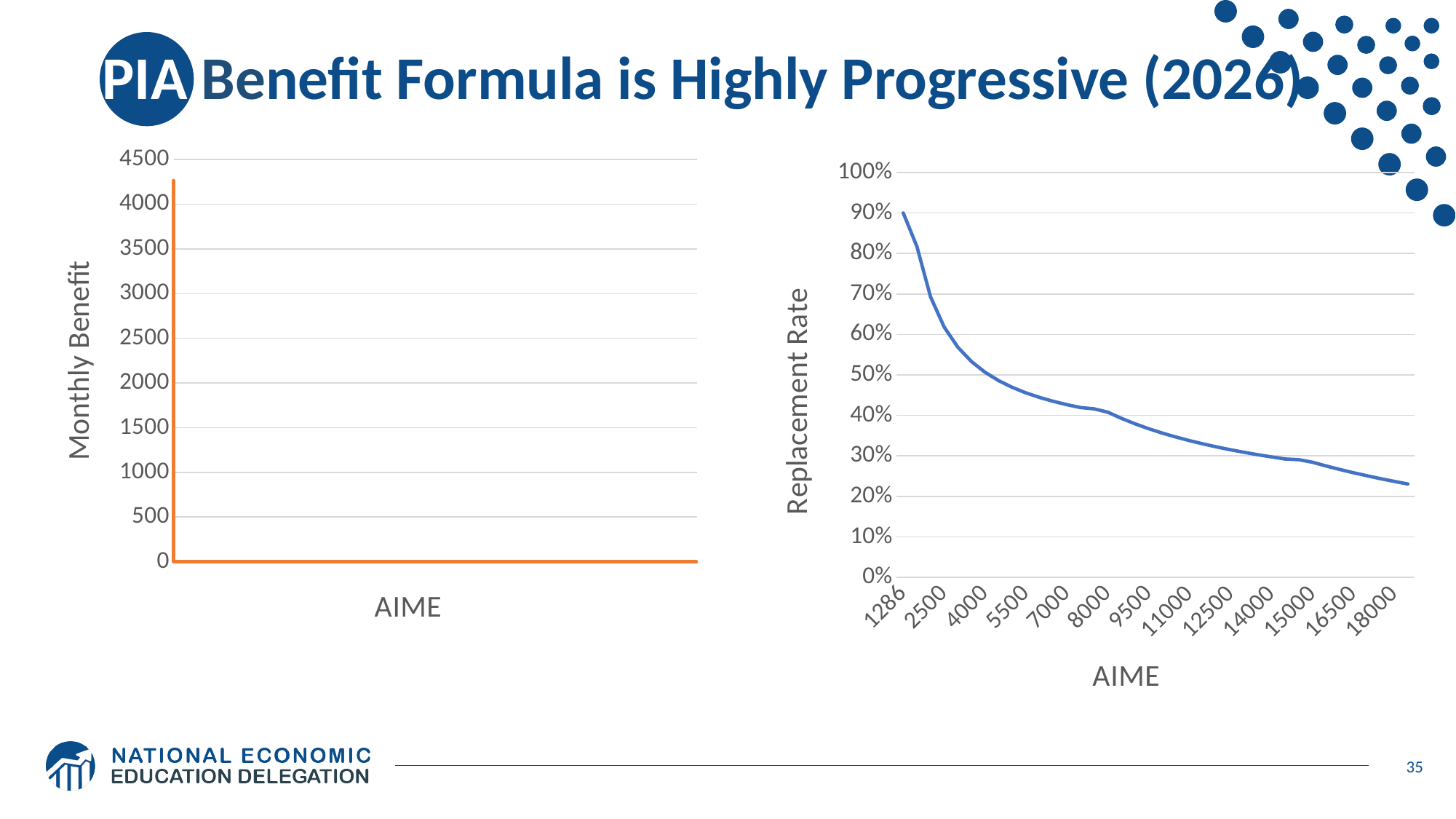
What is the y-axis title of the left-hand chart? Monthly Benefit What is the y-axis title of the right-hand chart? Replacement Rate In the right-hand chart, at which AIME value is the replacement rate highest? 1286 In the right-hand chart, does the replacement rate rise or fall as AIME increases? fall In the right-hand chart, is the replacement rate at AIME 2500 greater or less than 70%? less In the right-hand chart, is the replacement rate at AIME 5500 greater or less than 50%? less In the right-hand chart, which has the higher replacement rate: AIME 4000 or AIME 12500? AIME 4000 In the right-hand chart, is the replacement rate at AIME 18000 greater or less than 30%? less What kind of chart is the right-hand chart (Replacement Rate vs AIME)? line chart How many AIME tick labels are shown on the x axis of the right-hand chart? 13